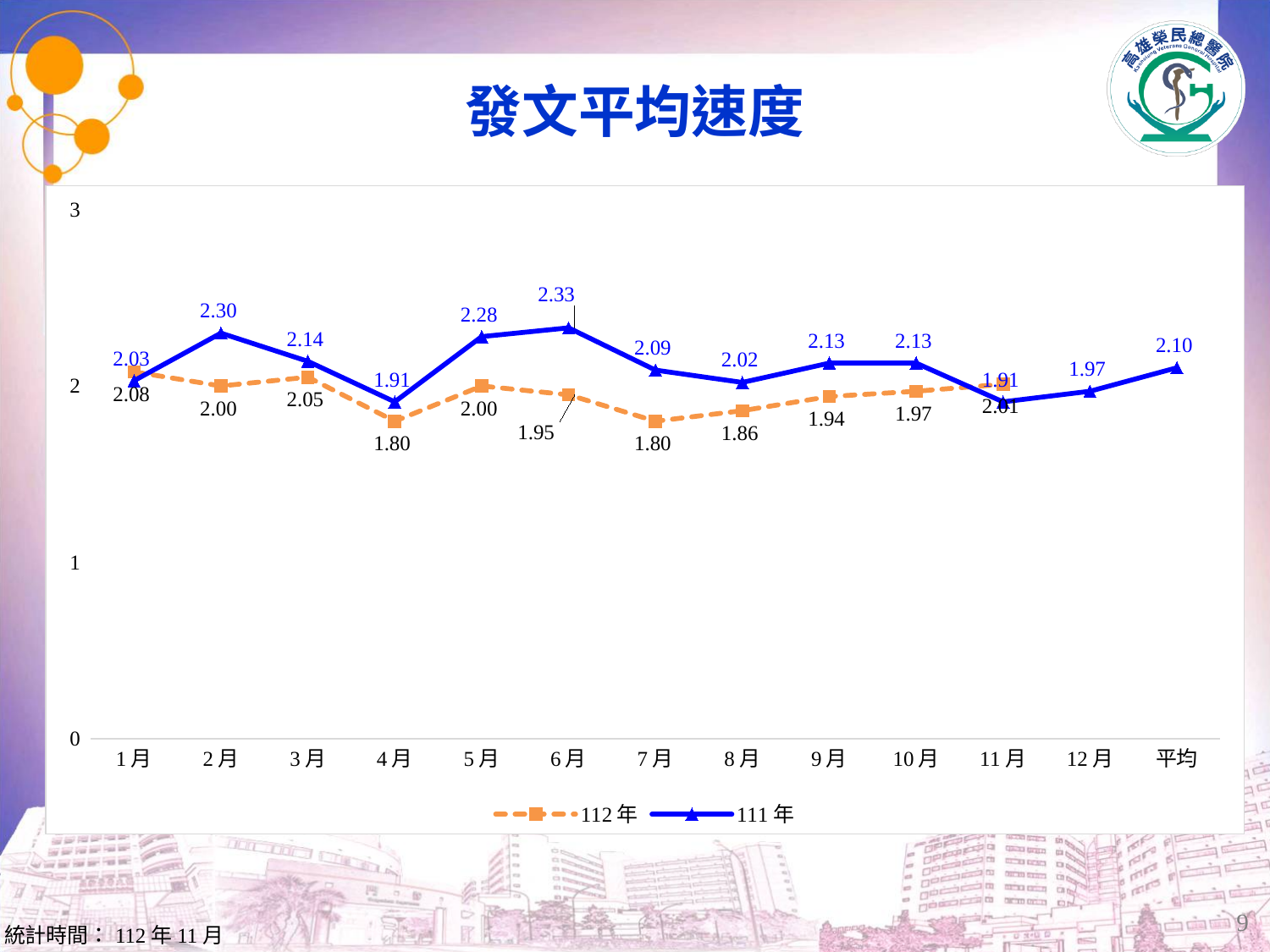
In which month does 112年 reach its highest value? 1月 Is the value for 111年 in 5月 greater or less than 2? greater What is the 平均 value for 111年? 2.10 In which month does 111年 reach its highest value? 6月 What is the difference between 111年 and 112年 in 6月? 0.38 How many series does the legend list? 2 What kind of chart is shown on the slide? line chart How much higher is 111年 in 2月 than in 1月? 0.27 What is the value for 112年 in 4月? 1.80 How many categories are shown on the x axis? 13 What is the value for 111年 in 6月? 2.33 In 2月, which series has the higher value, 111年 or 112年? 111年